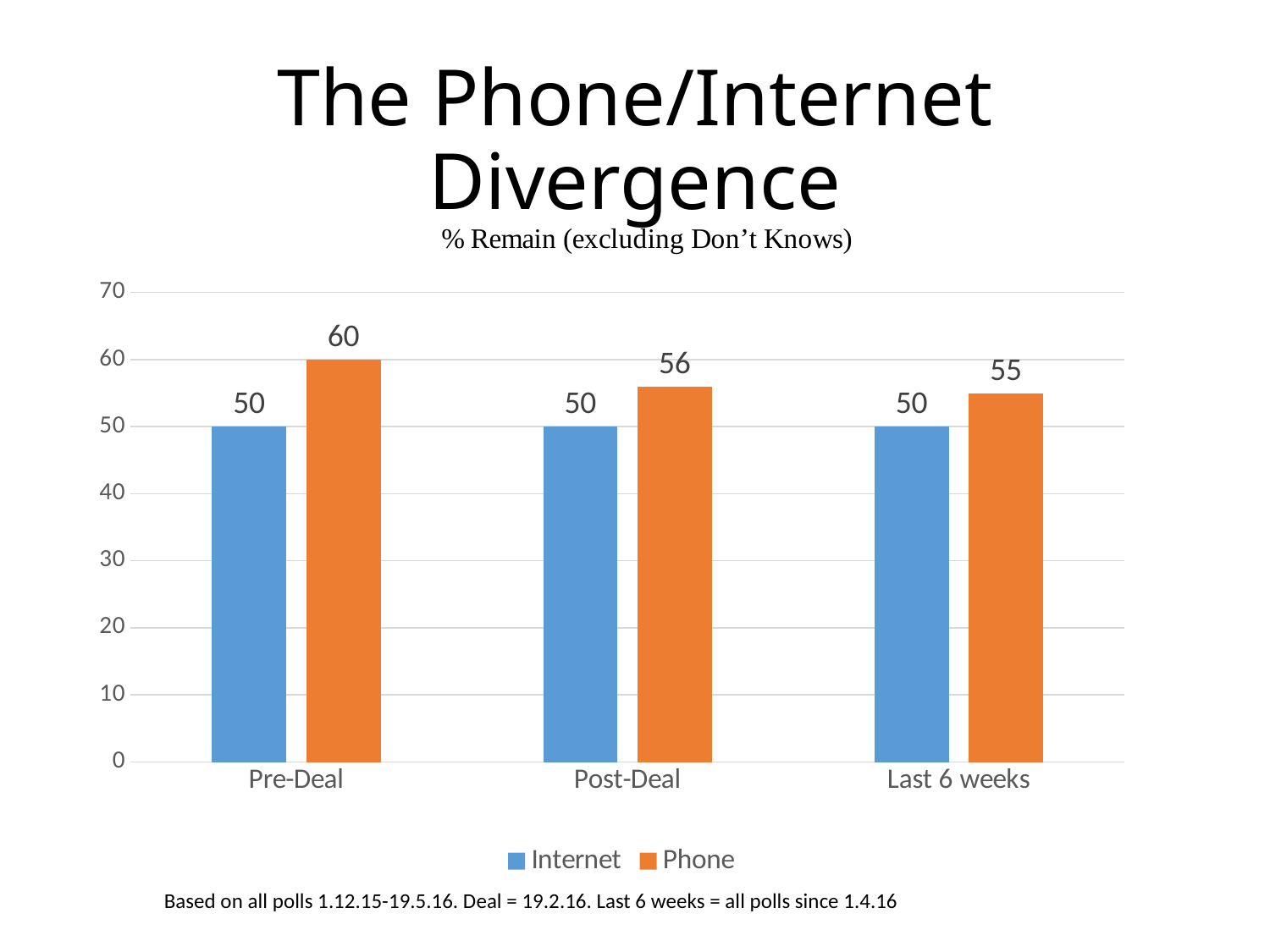
Do the Phone values rise or fall from Pre-Deal to Last 6 weeks? Fall What is the difference between the Phone values for Post-Deal and Last 6 weeks? 1 What kind of chart is shown on the slide? Bar chart What is the Phone value for Last 6 weeks? 55 How many series does the legend list? 2 How many categories are shown on the x axis? 3 Which category has the lowest Phone value? Last 6 weeks Which category has the highest Phone value? Pre-Deal What is the Internet value for Post-Deal? 50 What is the difference between the Phone and Internet values for Pre-Deal? 10 Which is larger for Post-Deal, the Internet value or the Phone value? Phone What is the Phone value for Pre-Deal? 60